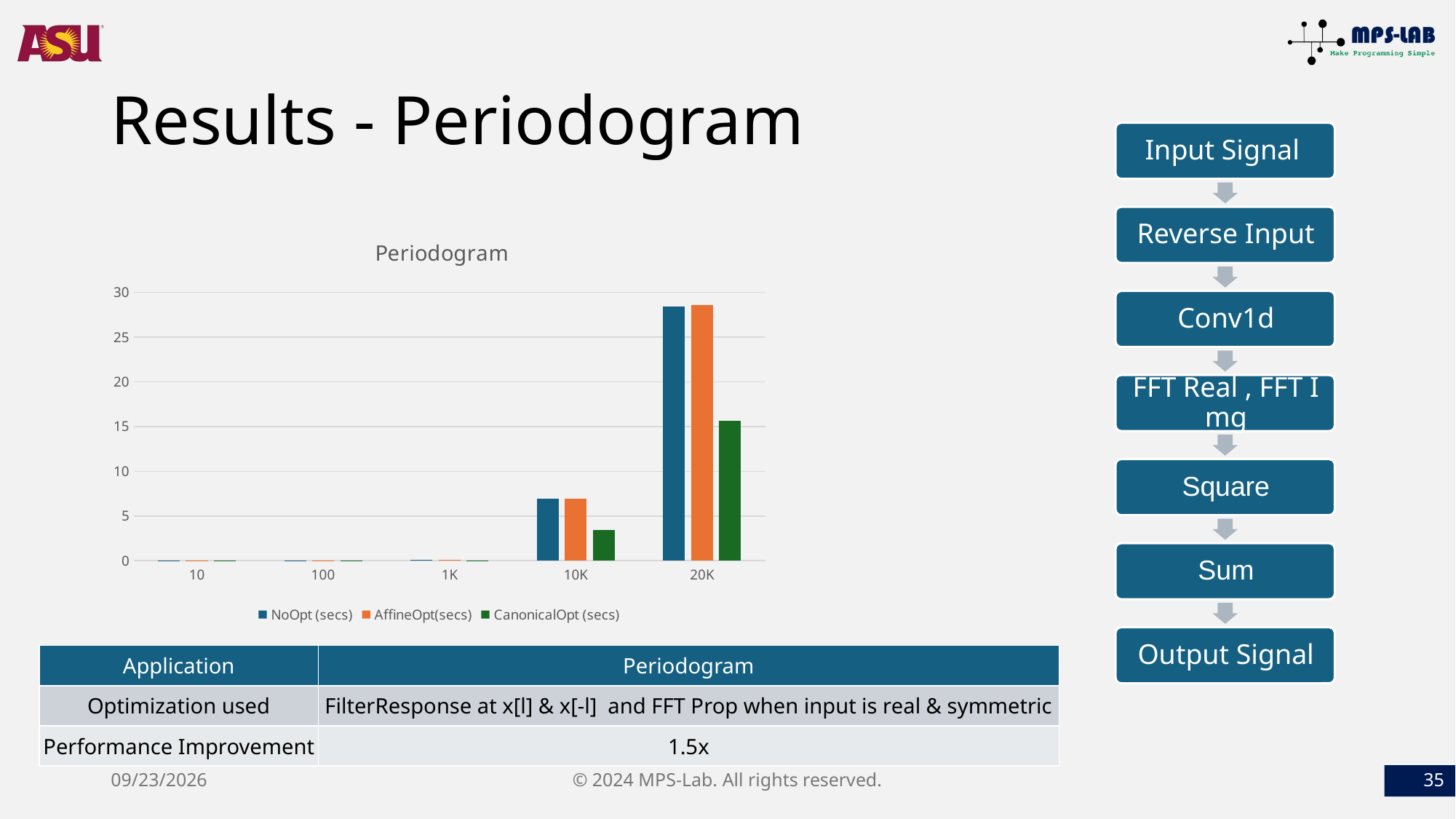
How many series does the chart legend list? 3 Which series is shown in green in the chart legend? CanonicalOpt (secs) What is the title of the chart? Periodogram Is the value for CanonicalOpt (secs) at 10K greater or less than 5? less Is the value for CanonicalOpt (secs) at 20K greater or less than 20? less At 20K, which is larger: NoOpt (secs) or CanonicalOpt (secs)? NoOpt (secs) What kind of chart is shown on the slide? bar chart Is the value for NoOpt (secs) at 20K greater or less than 25? greater For which category is the NoOpt (secs) value highest? 20K How many categories are shown on the x axis of the chart? 5